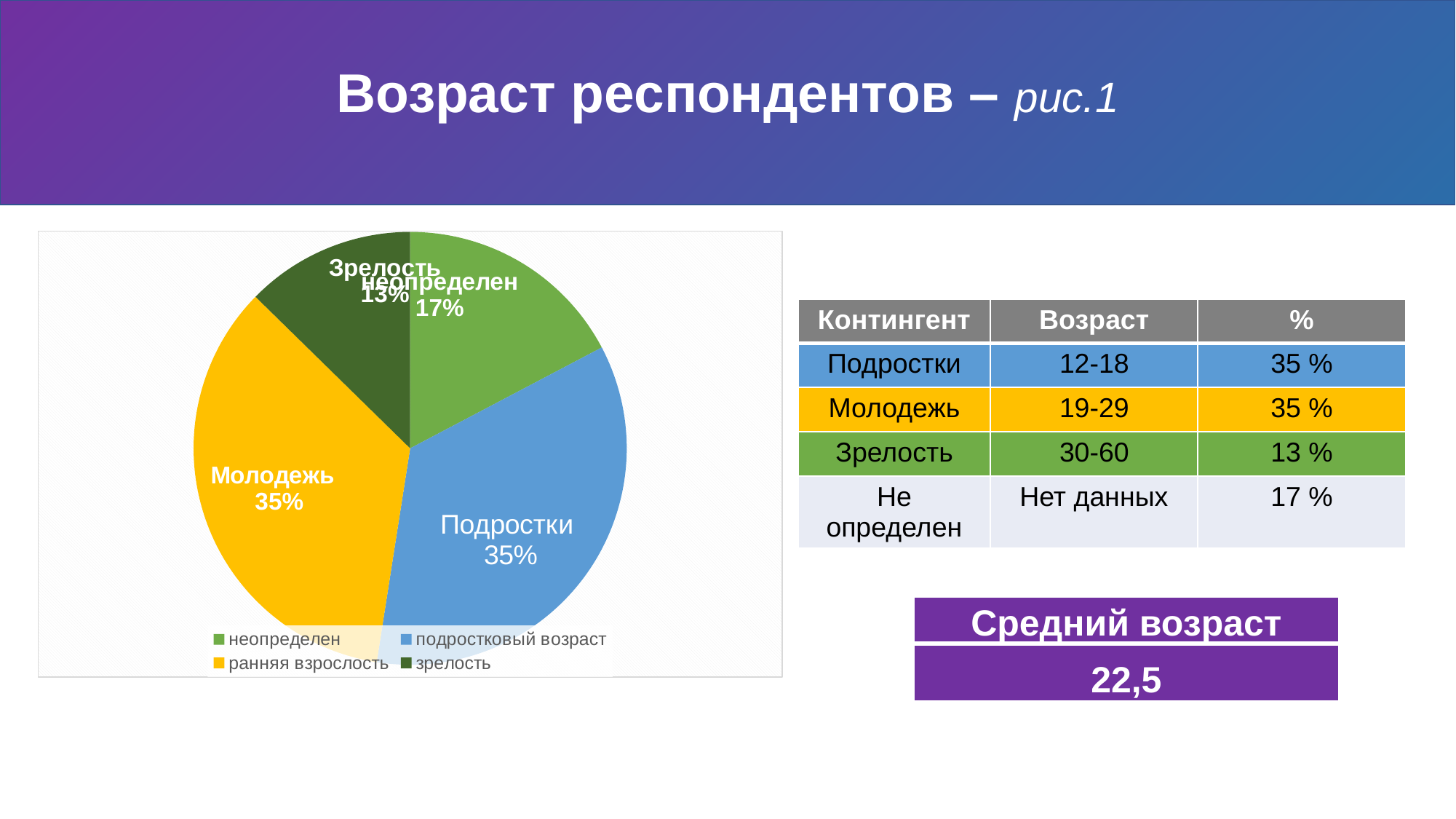
What is the value shown for the Молодежь slice? 35% What kind of chart is shown on the slide? pie chart What share of the pie does the Подростки slice represent? 35% How many entries does the chart legend list? 4 What is the value shown for the неопределен slice? 17% How many slices does the pie chart have? 4 Which slice of the pie is the smallest? Зрелость What is the difference between the неопределен slice and the Зрелость slice? 4% What colour is the Молодежь slice in the pie chart? yellow Which legend entry corresponds to the blue slice? подростковый возраст What is the value shown for the Зрелость slice? 13% Which is larger, the неопределен slice or the Зрелость slice? неопределен